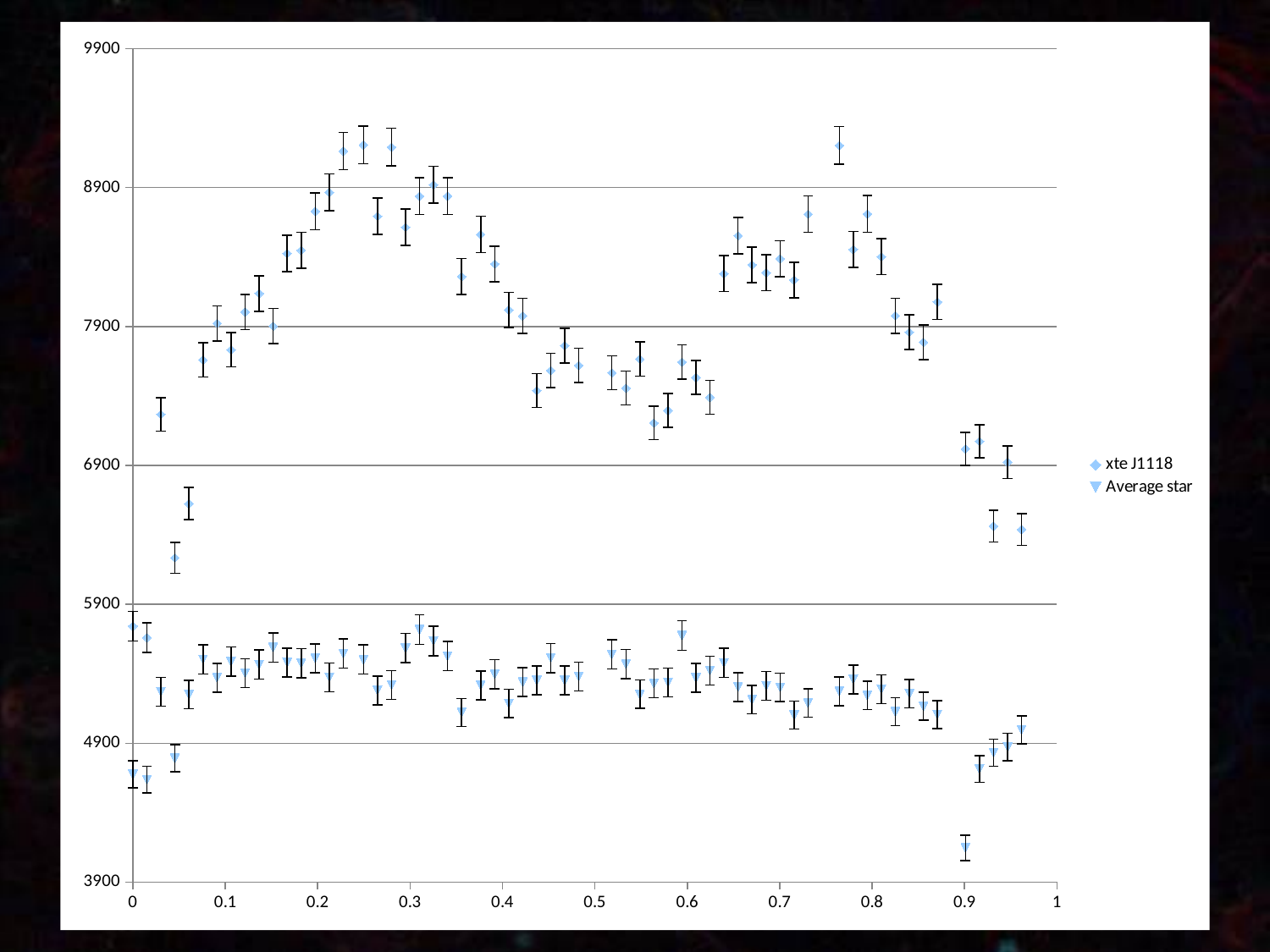
Is the xte J1118 value at x = 0.25 larger or smaller than its value at x = 0.5? larger What kind of chart is shown on the slide? scatter chart At x = 0.5, which series has the higher value, xte J1118 or Average star? xte J1118 What are the names of the two series shown in the legend? xte J1118 and Average star Is the value for xte J1118 at x = 0.77 greater or less than 8900? greater How many series does the legend list? 2 Between x = 0.1 and x = 0.25, do the xte J1118 values rise or fall? rise Is the value for Average star at x = 0.3 greater or less than 4900? greater Is the value for xte J1118 at x = 0.05 greater or less than 5900? greater